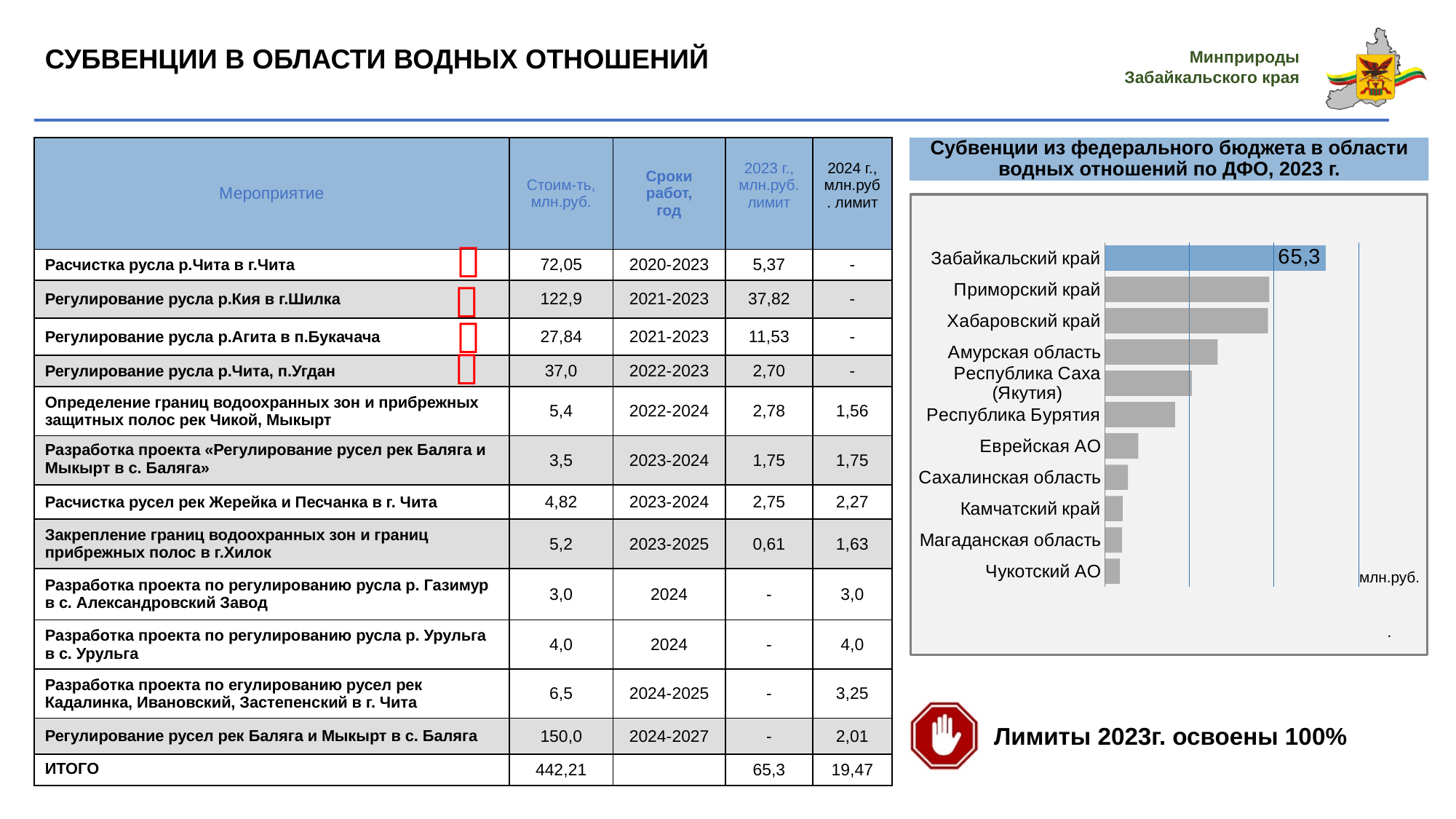
Which has the larger value in the chart, Приморский край or Амурская область? Приморский край Which region has the highest value in the chart? Забайкальский край Which has the larger value in the chart, Забайкальский край or Приморский край? Забайкальский край How many regions are shown in the chart? 11 What unit is indicated on the chart's axis? млн.руб. Which has the larger value in the chart, Хабаровский край or Еврейская АО? Хабаровский край What is the value shown for Забайкальский край in the chart? 65,3 What is the title of the chart? Субвенции из федерального бюджета в области водных отношений по ДФО, 2023 г. What kind of chart is shown on the slide? Bar chart